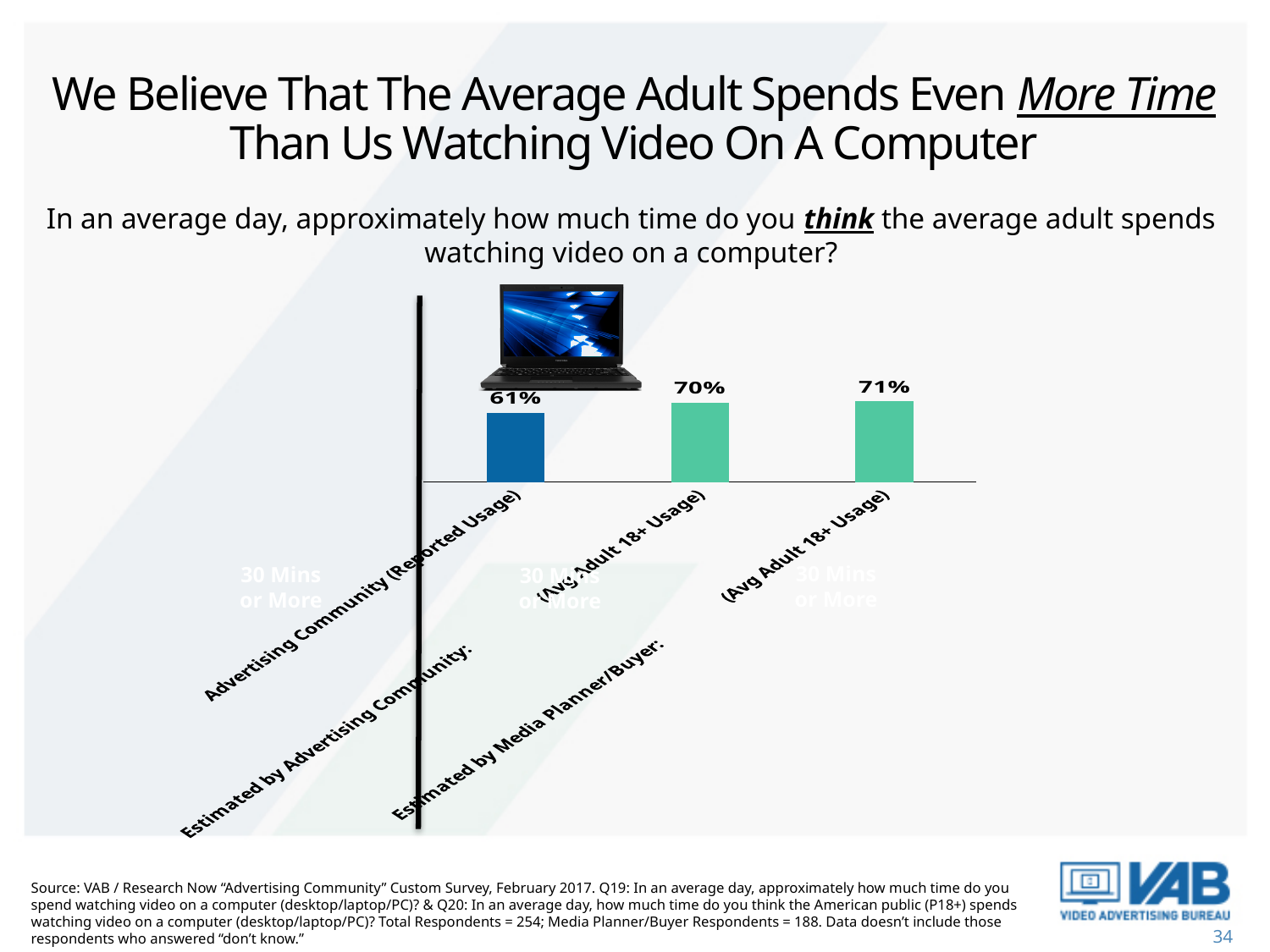
What kind of chart is shown on the slide? Bar chart What percentage is shown for Advertising Community (Reported Usage)? 61% What value is shown for the bar labelled Estimated by Media Planner/Buyer (Avg Adult 18+ Usage)? 71% Which bar has the highest value? Estimated by Media Planner/Buyer (Avg Adult 18+ Usage) How many bars are plotted in the chart? 3 What colour is the bar for Advertising Community (Reported Usage)? Dark blue What is the difference between the Estimated by Media Planner/Buyer value and the Advertising Community (Reported Usage) value? 10 percentage points What value is shown for the bar labelled Estimated by Advertising Community (Avg Adult 18+ Usage)? 70% What is the difference between the Estimated by Advertising Community value and the Advertising Community (Reported Usage) value? 9 percentage points Do the bar values rise or fall from left to right? Rise Which is larger: the value estimated by Media Planner/Buyer or the value estimated by the Advertising Community? Estimated by Media Planner/Buyer Which bar has the lowest value? Advertising Community (Reported Usage)